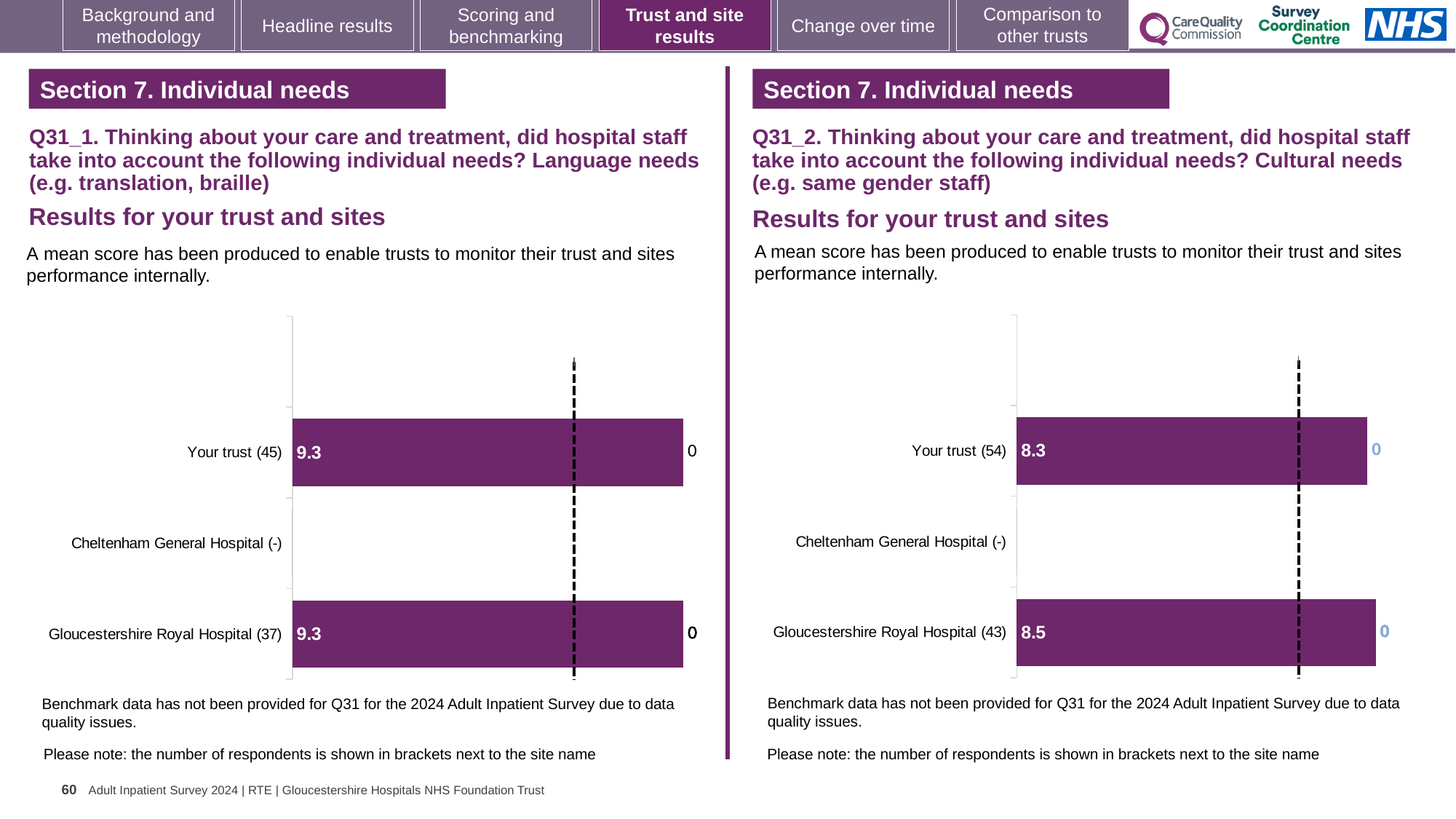
In the Q31_2 Cultural needs chart on the right, what is the mean score for Gloucestershire Royal Hospital (43)? 8.5 In the Q31_1 Language needs chart on the left, what is the difference between the mean scores for Your trust and Gloucestershire Royal Hospital? 0 In the Q31_2 Cultural needs chart on the right, how many respondents are shown in brackets for Your trust? 54 In the Q31_1 Language needs chart on the left, what is the mean score for Gloucestershire Royal Hospital (37)? 9.3 In the Q31_2 Cultural needs chart on the right, which category has the lowest plotted mean score? Your trust (54) In the Q31_2 Cultural needs chart on the right, which has the higher mean score: Your trust or Gloucestershire Royal Hospital? Gloucestershire Royal Hospital In the Q31_1 Language needs chart on the left, what is the mean score for Your trust (45)? 9.3 What type of chart is used for the Q31_2 Cultural needs results on the right? Bar chart How many categories are listed on the vertical axis of the Q31_1 Language needs chart on the left? 3 In the Q31_2 Cultural needs chart on the right, what is the mean score for Your trust (54)? 8.3 In the Q31_2 Cultural needs chart on the right, what is the difference between the mean scores for Gloucestershire Royal Hospital and Your trust? 0.2 In the Q31_1 Language needs chart on the left, which category has no bar plotted? Cheltenham General Hospital (-)